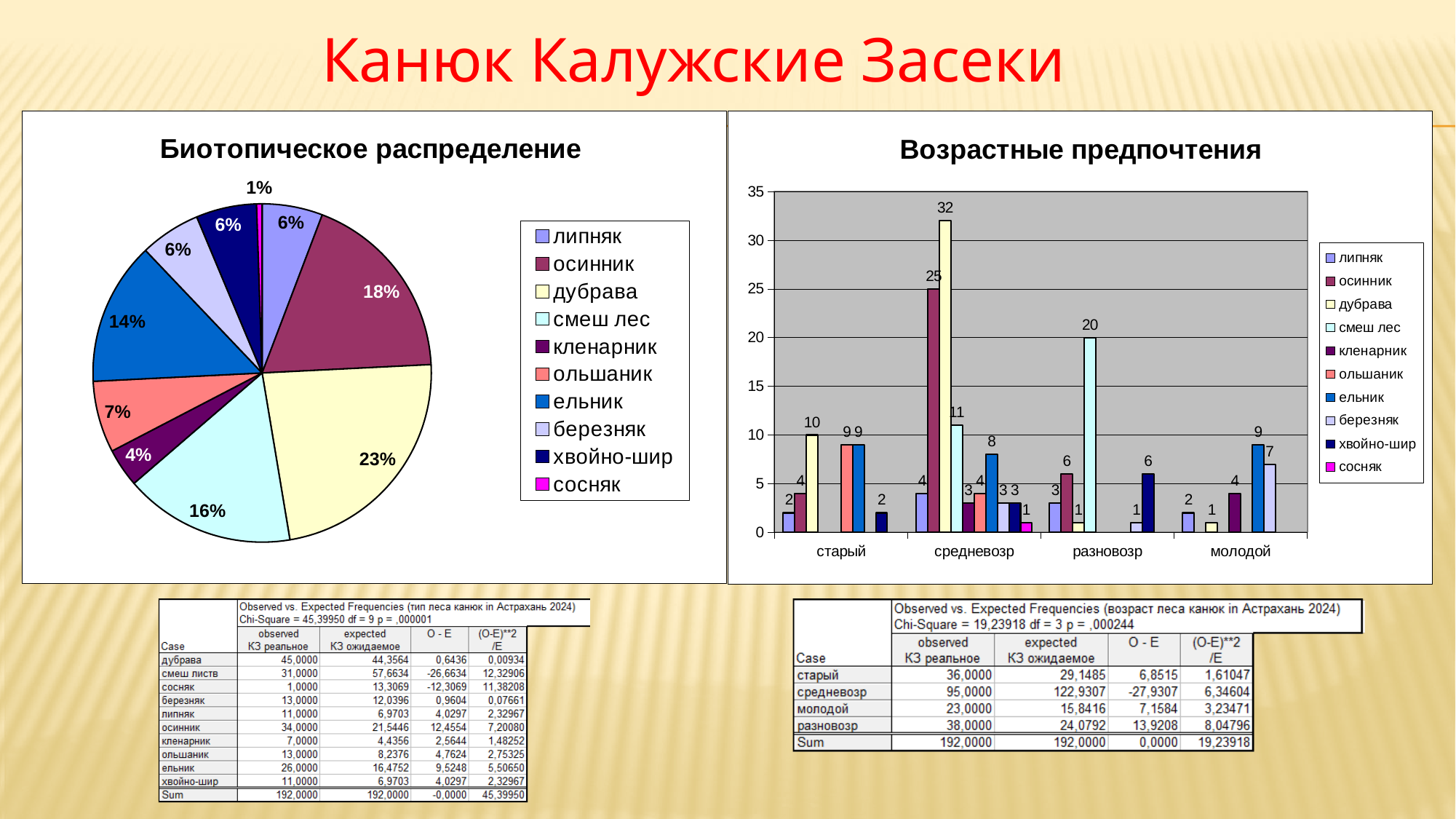
In the bar chart "Возрастные предпочтения", which is larger in the молодой category, ельник or березняк? ельник In the pie chart "Биотопическое распределение", what share does ельник have? 14% How many series does the legend of the bar chart "Возрастные предпочтения" list? 10 In the bar chart "Возрастные предпочтения", what is the value for смеш лес in the разновозр category? 20 In the pie chart "Биотопическое распределение", which category has the smallest slice? сосняк In the bar chart "Возрастные предпочтения", what is the difference between дубрава and осинник in the средневозр category? 7 In the pie chart "Биотопическое распределение", which slice is larger, осинник or смеш лес? осинник How many categories are shown on the x axis of the bar chart "Возрастные предпочтения"? 4 In the bar chart "Возрастные предпочтения", what is the value for дубрава in the средневозр category? 32 What kind of chart is "Возрастные предпочтения"? bar chart In the pie chart "Биотопическое распределение", which category has the largest slice? дубрава In the pie chart "Биотопическое распределение", what share does дубрава have? 23%